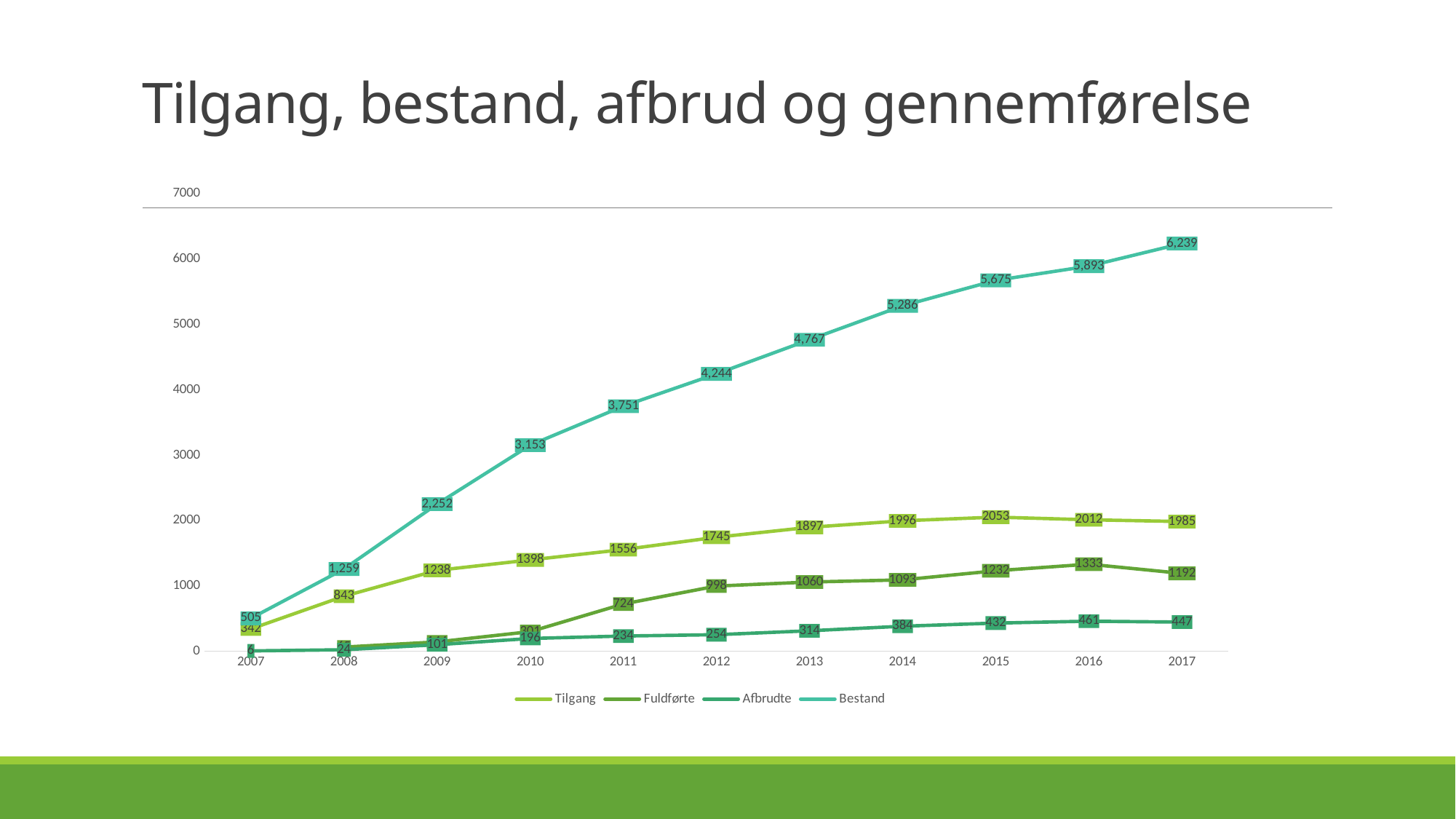
In which year does Fuldførte reach its highest value? 2016 What is the value of Fuldførte in 2016? 1333 What kind of chart is shown on the slide? line chart Which is larger in 2012, Tilgang or Fuldførte? Tilgang What is the value of Afbrudte in 2014? 384 How many series does the legend list? 4 By how much did Bestand increase from 2016 to 2017? 346 In which year does Tilgang reach its highest value? 2015 What is the value of Tilgang in 2015? 2053 What is the value of Bestand in 2017? 6,239 Is the value of Bestand in 2013 greater or less than 5000? less How many years are shown on the x axis? 11